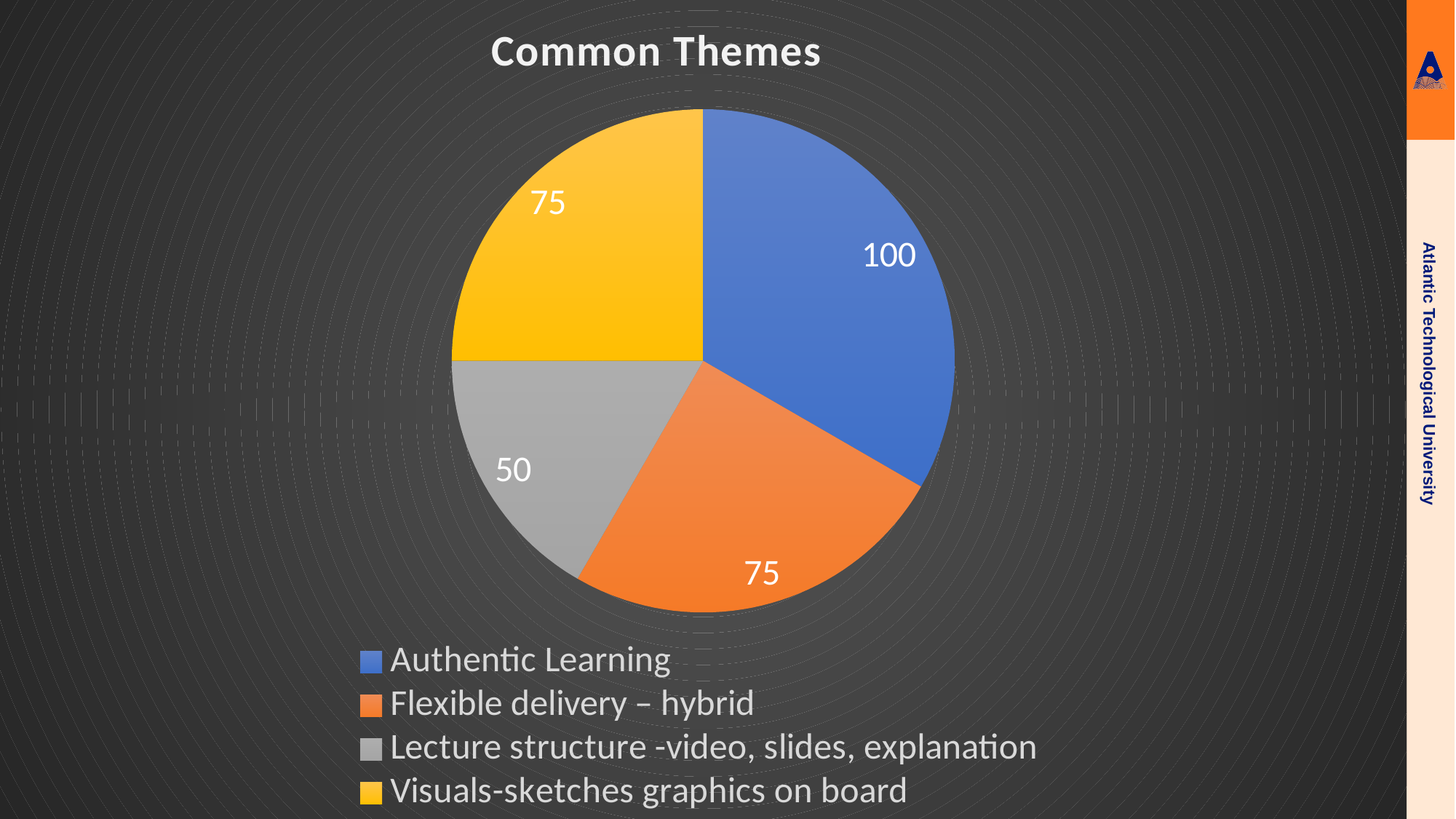
What is the value for Authentic Learning? 100 What share of the pie does Authentic Learning represent? 1/3 How many categories does the pie chart show? 4 What is the title of the chart? Common Themes Which category has the smallest slice? Lecture structure -video, slides, explanation What is the value for Lecture structure -video, slides, explanation? 50 Which category has the largest slice? Authentic Learning What kind of chart is shown on the slide? Pie chart Which is larger, the value for Authentic Learning or the value for Flexible delivery – hybrid? Authentic Learning What is the value for Visuals-sketches graphics on board? 75 What is the value for Flexible delivery – hybrid? 75 What is the difference between the values for Authentic Learning and Lecture structure -video, slides, explanation? 50